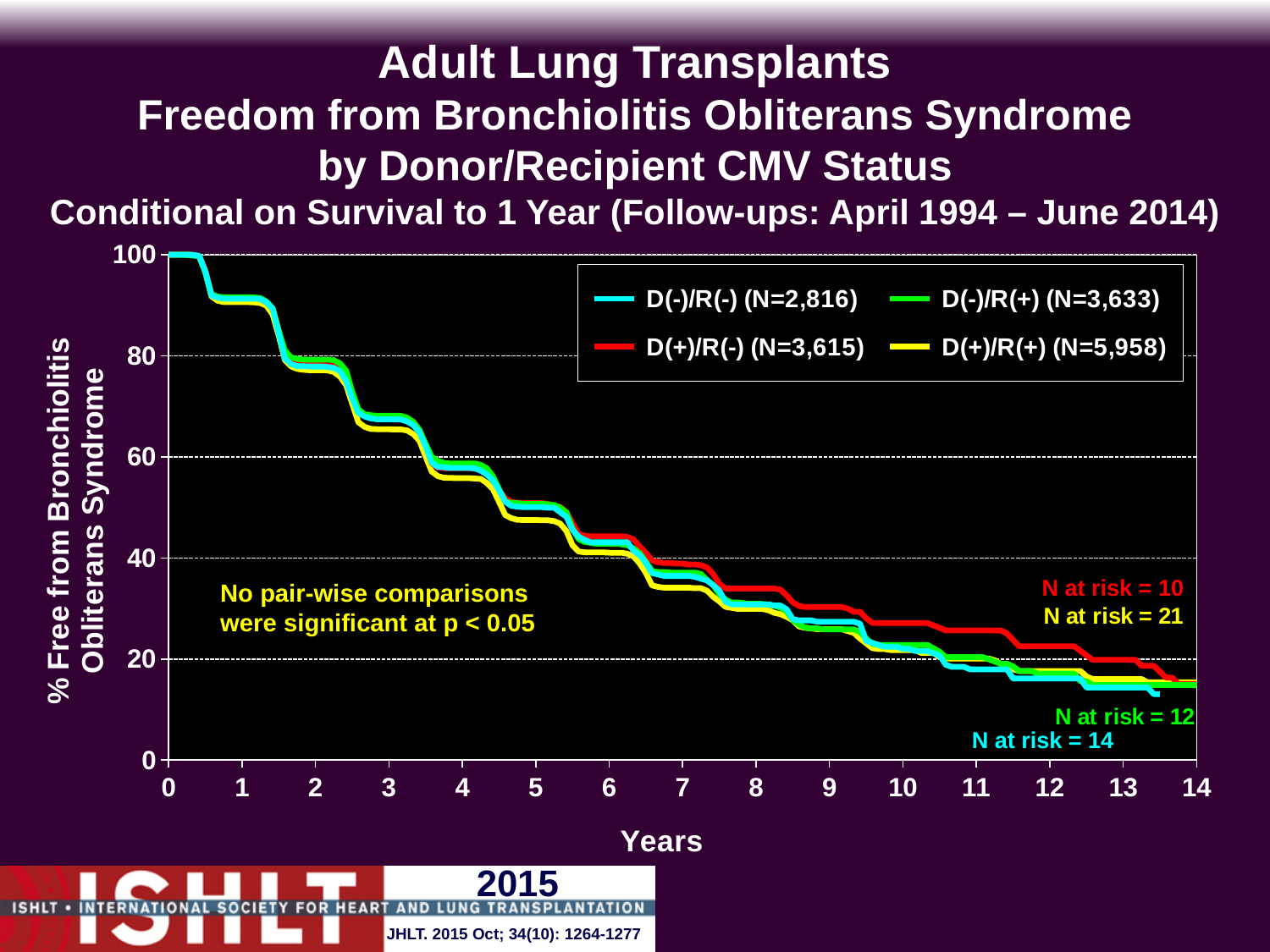
Is the value for the D(-)/R(-) curve at year 1 greater or less than 80? greater Which donor/recipient CMV group has the smallest N in the legend? D(-)/R(-) Do the curves rise or fall as years since transplant increase? fall What kind of chart is shown on the slide? line chart Which curve is highest at year 10? D(+)/R(-) Which donor/recipient CMV group has the largest N in the legend? D(+)/R(+) Which has a larger N at risk at the end of follow-up, the D(+)/R(-) group (red) or the D(+)/R(+) group (yellow)? D(+)/R(+) What is the N for the D(+)/R(+) group shown in the legend? 5,958 What is the N for the D(-)/R(-) group shown in the legend? 2,816 What is the N at risk shown for the red D(+)/R(-) curve at the end of follow-up? 10 What is the difference between the N of the D(+)/R(+) group and the N of the D(-)/R(-) group? 3,142 How many series does the legend list? 4